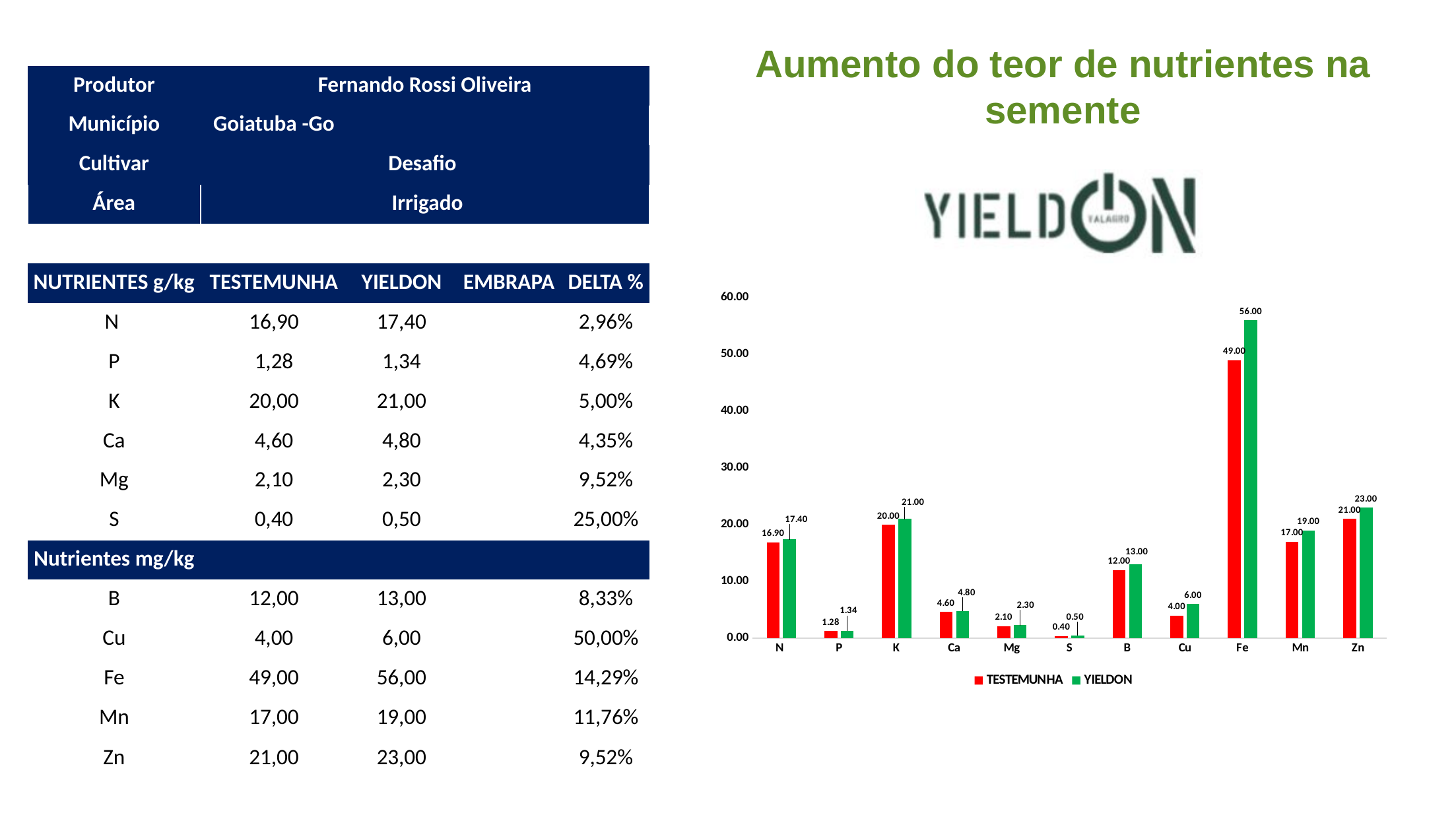
What type of chart is shown on the slide? bar chart Which series in the chart legend is shown in green? YIELDON Which is larger in the chart: the YIELDON value for Mn or the YIELDON value for Zn? Zn What is the difference between the YIELDON and TESTEMUNHA values for Fe in the chart? 7.00 How many nutrient categories are plotted on the x axis of the chart? 11 Which nutrient has the lowest TESTEMUNHA value in the chart? S What is the YIELDON value for Fe in the chart? 56.00 Which nutrient has the highest YIELDON value in the chart? Fe How many series does the chart legend list? 2 What is the TESTEMUNHA value for K in the chart? 20.00 What is the YIELDON value for Cu in the chart? 6.00 Is the TESTEMUNHA value for Fe greater or less than 40.00? greater